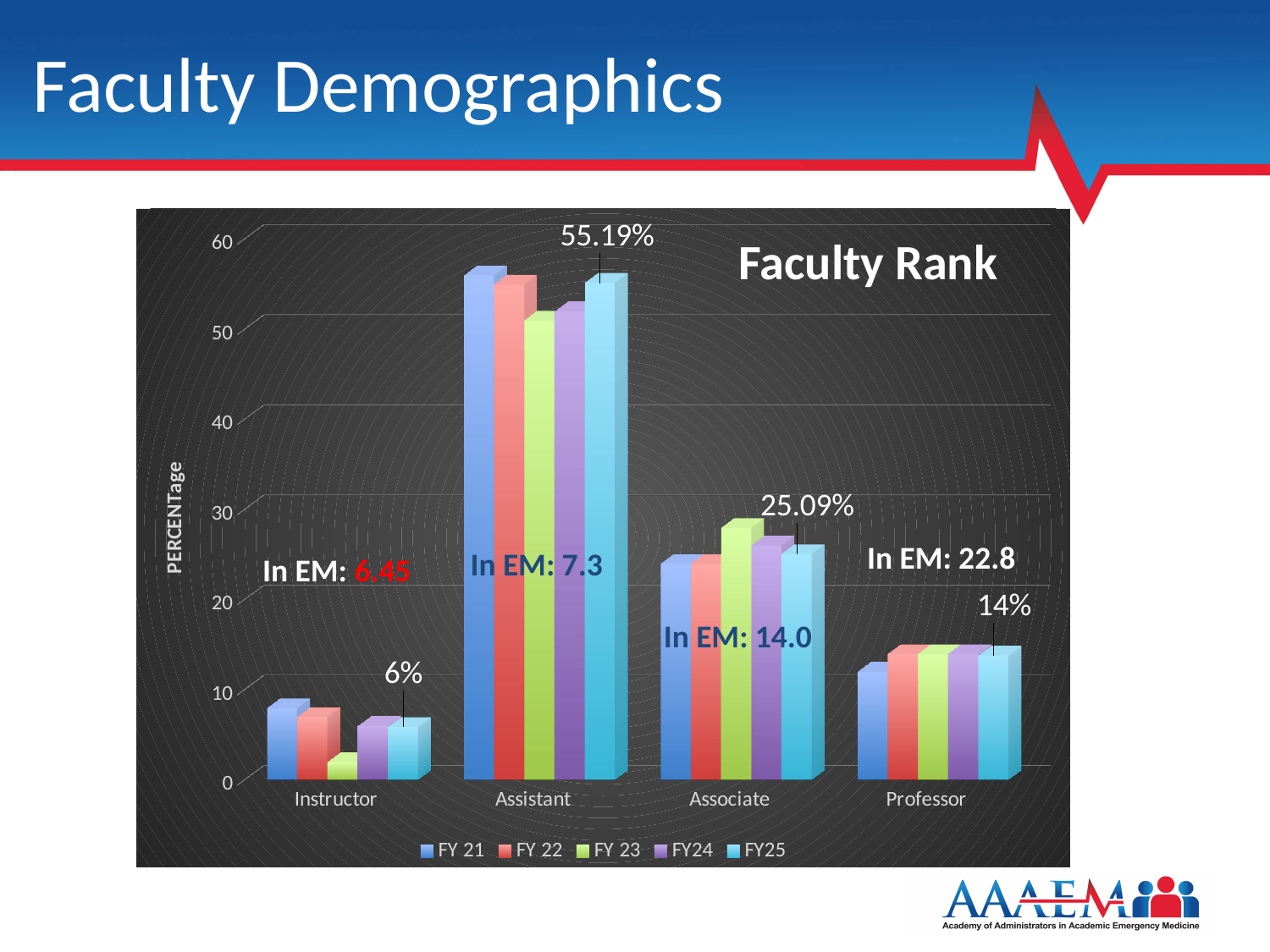
What is the FY25 value for Professor? 14% Which faculty rank has the lowest FY25 value? Instructor How many faculty rank categories are shown on the x axis? 4 What is the FY25 value for Associate? 25.09% What is the title of the chart? Faculty Rank Is the FY 21 value for Assistant greater or less than 50? greater What kind of chart is shown on the slide? bar chart What is the FY25 value for Instructor? 6% Which faculty rank has the highest FY25 value? Assistant How many series does the legend list? 5 What is the FY25 value for Assistant? 55.19% What is the difference between the FY25 values for Professor and Instructor? 8%